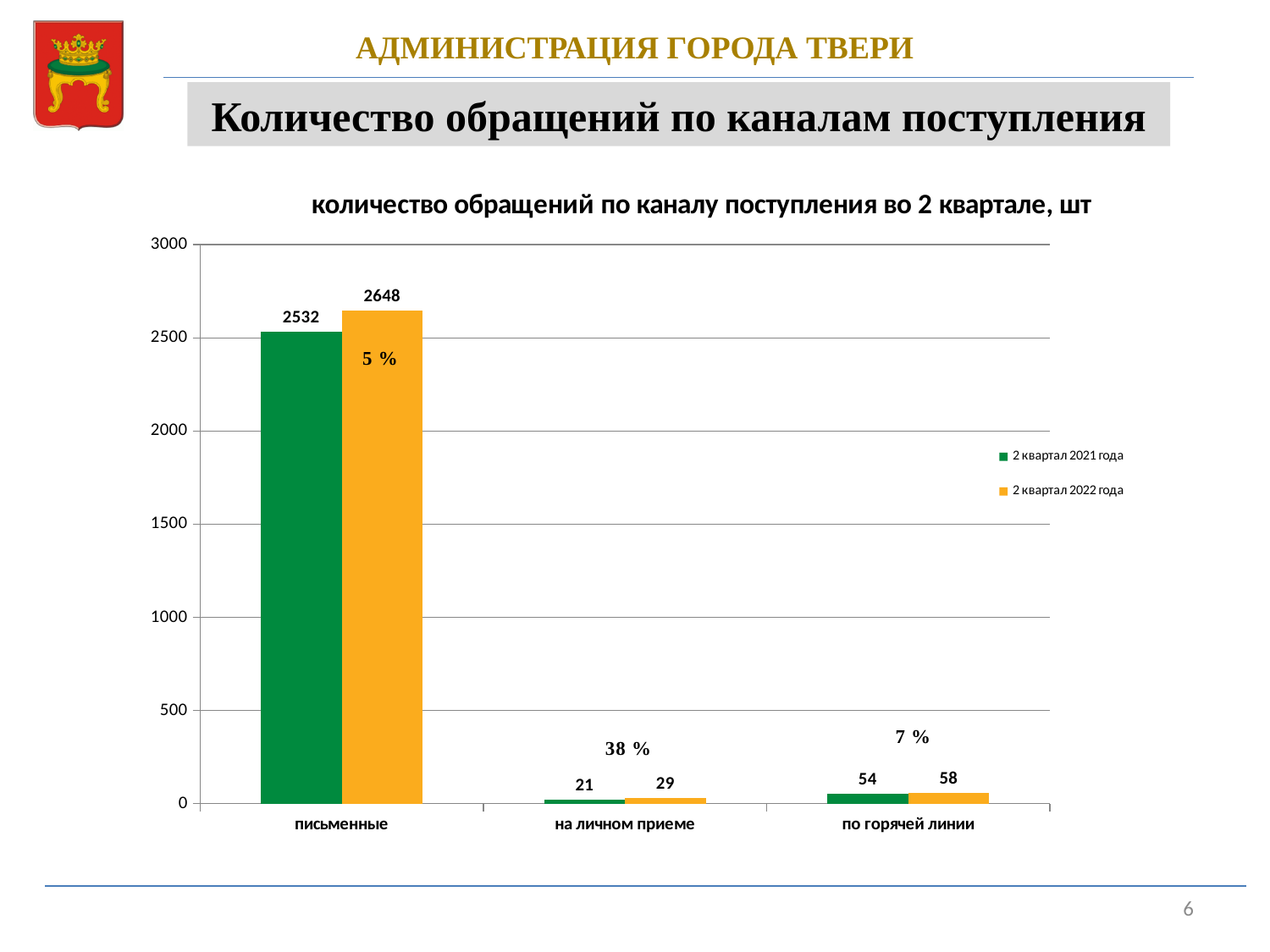
How many categories are shown on the x axis? 3 How many series does the legend list? 2 What kind of chart is shown on the slide? bar chart Which is larger for на личном приеме: the 2 квартал 2021 года value or the 2 квартал 2022 года value? 2 квартал 2022 года What is the difference between the 2 квартал 2022 года and 2 квартал 2021 года values for письменные? 116 What is the value for по горячей линии in 2 квартал 2021 года? 54 What is the value for письменные in 2 квартал 2021 года? 2532 What is the difference between the 2 квартал 2022 года and 2 квартал 2021 года values for по горячей линии? 4 What is the value for письменные in 2 квартал 2022 года? 2648 Which category has the lowest value in 2 квартал 2021 года? на личном приеме Which category has the highest value in 2 квартал 2022 года? письменные What is the value for на личном приеме in 2 квартал 2022 года? 29